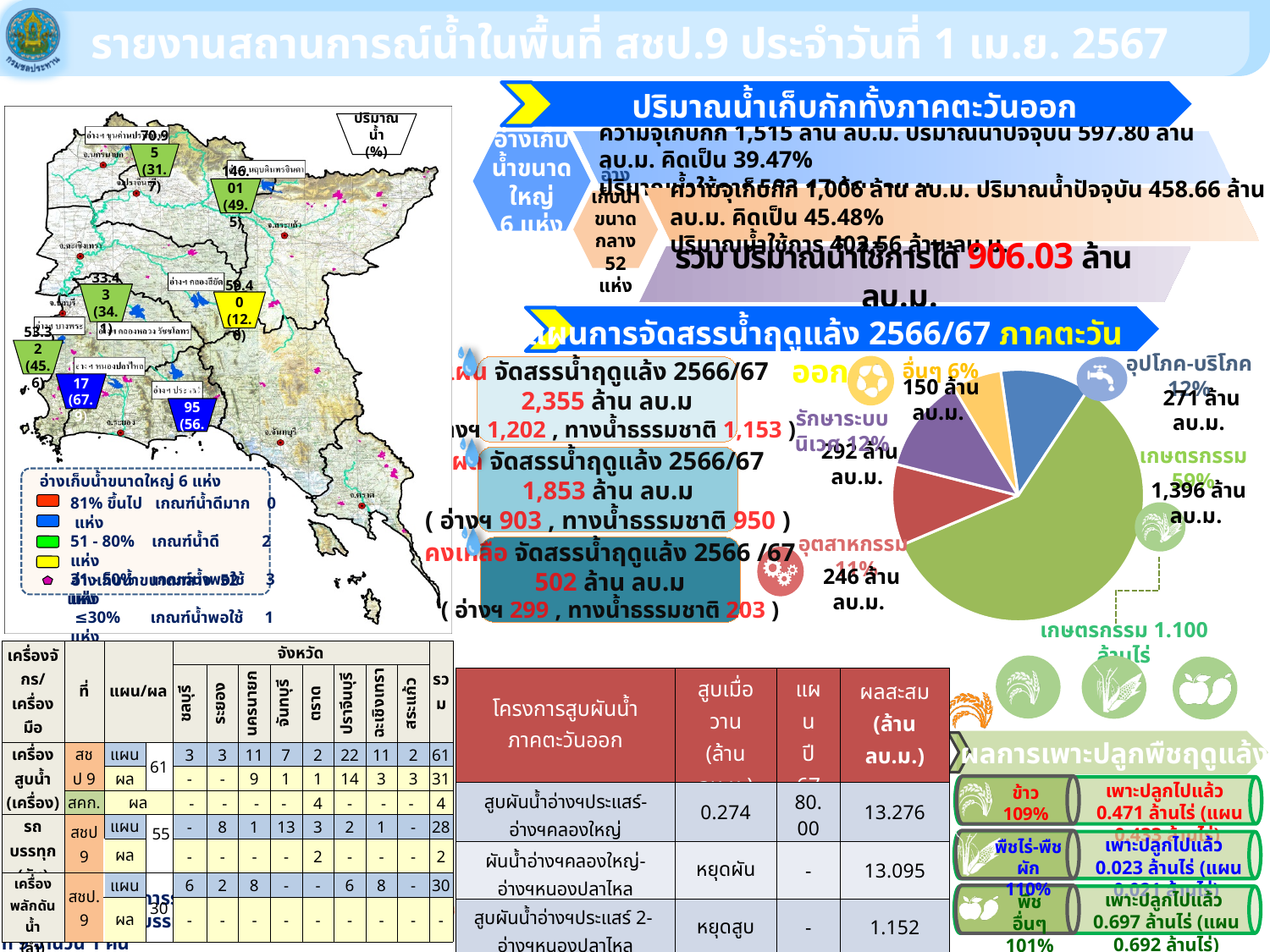
In the water allocation pie chart, how many slices (categories) are shown? 5 In the water allocation pie chart, which category has the largest share? เกษตรกรรม In the water allocation pie chart, what is the value for รักษาระบบนิเวศ? 292 ล้าน ลบ.ม. In the water allocation pie chart, what is the value for อื่นๆ? 150 ล้าน ลบ.ม. In the water allocation pie chart, which is larger: อุปโภค-บริโภค or อุตสาหกรรม? อุปโภค-บริโภค In the water allocation pie chart, what percentage share does เกษตรกรรม have? 59% In the water allocation pie chart, what is the value for เกษตรกรรม? 1,396 ล้าน ลบ.ม. In the water allocation pie chart, which category has the smallest share? อื่นๆ What kind of chart is used to show the dry-season 2566/67 water allocation plan for the eastern region? pie chart In the water allocation pie chart, what is the difference between เกษตรกรรม and รักษาระบบนิเวศ in ล้าน ลบ.ม.? 1,104 In the water allocation pie chart, what is the value for อุปโภค-บริโภค? 271 ล้าน ลบ.ม. In the water allocation pie chart, what is the value for อุตสาหกรรม? 246 ล้าน ลบ.ม.